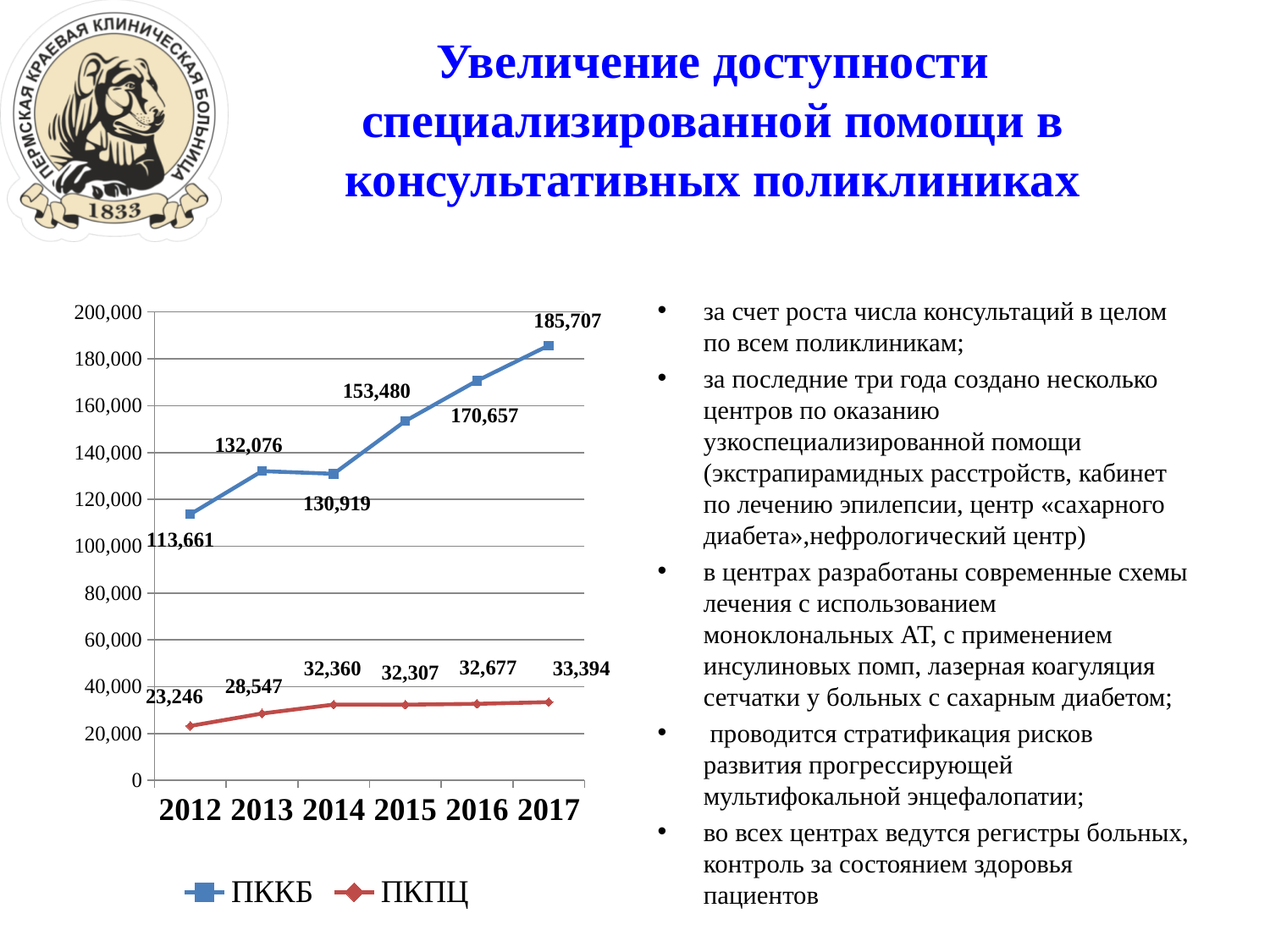
What type of chart is shown on the slide? line chart How many years are shown on the x axis? 6 What is the value for ПККБ in 2017? 185,707 What is the difference between the ПККБ and ПКПЦ values in 2012? 90,415 Which is larger: the ПККБ value in 2013 or the ПККБ value in 2014? 2013 What is the difference between the ПККБ values in 2017 and 2016? 15,050 Does the ПККБ series generally rise or fall from 2012 to 2017? rise In which year is the ПКПЦ value highest? 2017 What is the value for ПККБ in 2014? 130,919 How many series does the chart legend list? 2 What is the value for ПКПЦ in 2012? 23,246 In which year is the ПККБ value lowest? 2012